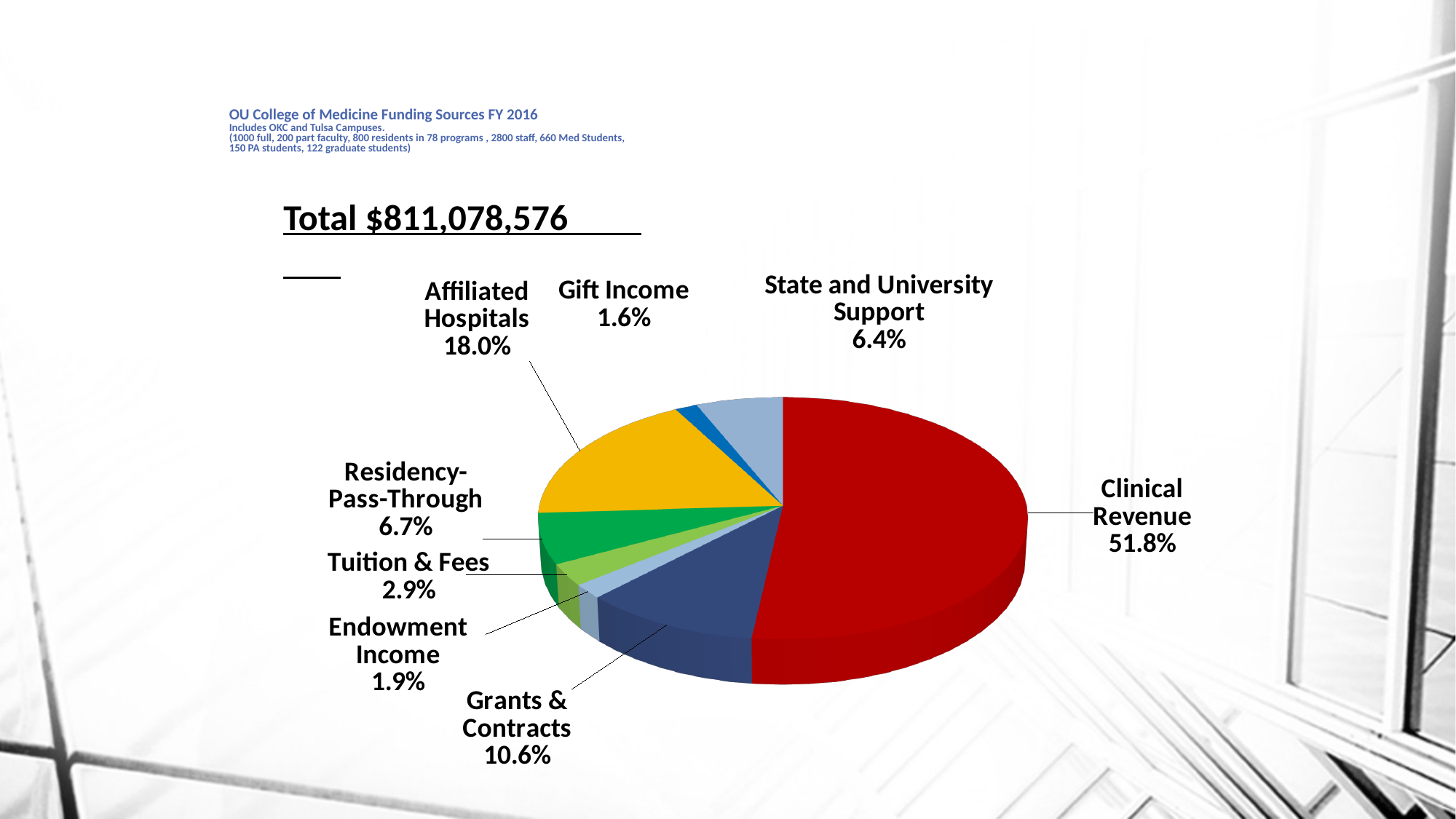
Which is larger, Residency-Pass-Through or State and University Support? Residency-Pass-Through What share of funding comes from Clinical Revenue? 51.8% What is the share for Endowment Income? 1.9% What percentage of funding is from Affiliated Hospitals? 18.0% How many slices does the pie chart have? 8 What is the total funding amount shown on the slide? $811,078,576 Which funding source has the largest share of the pie? Clinical Revenue What type of chart is shown on the slide? Pie chart Which funding source has the smallest share of the pie? Gift Income What is the difference in percentage points between Affiliated Hospitals and Grants & Contracts? 7.4 What is the share for Grants & Contracts? 10.6% What is the combined share of Tuition & Fees and Gift Income? 4.5%